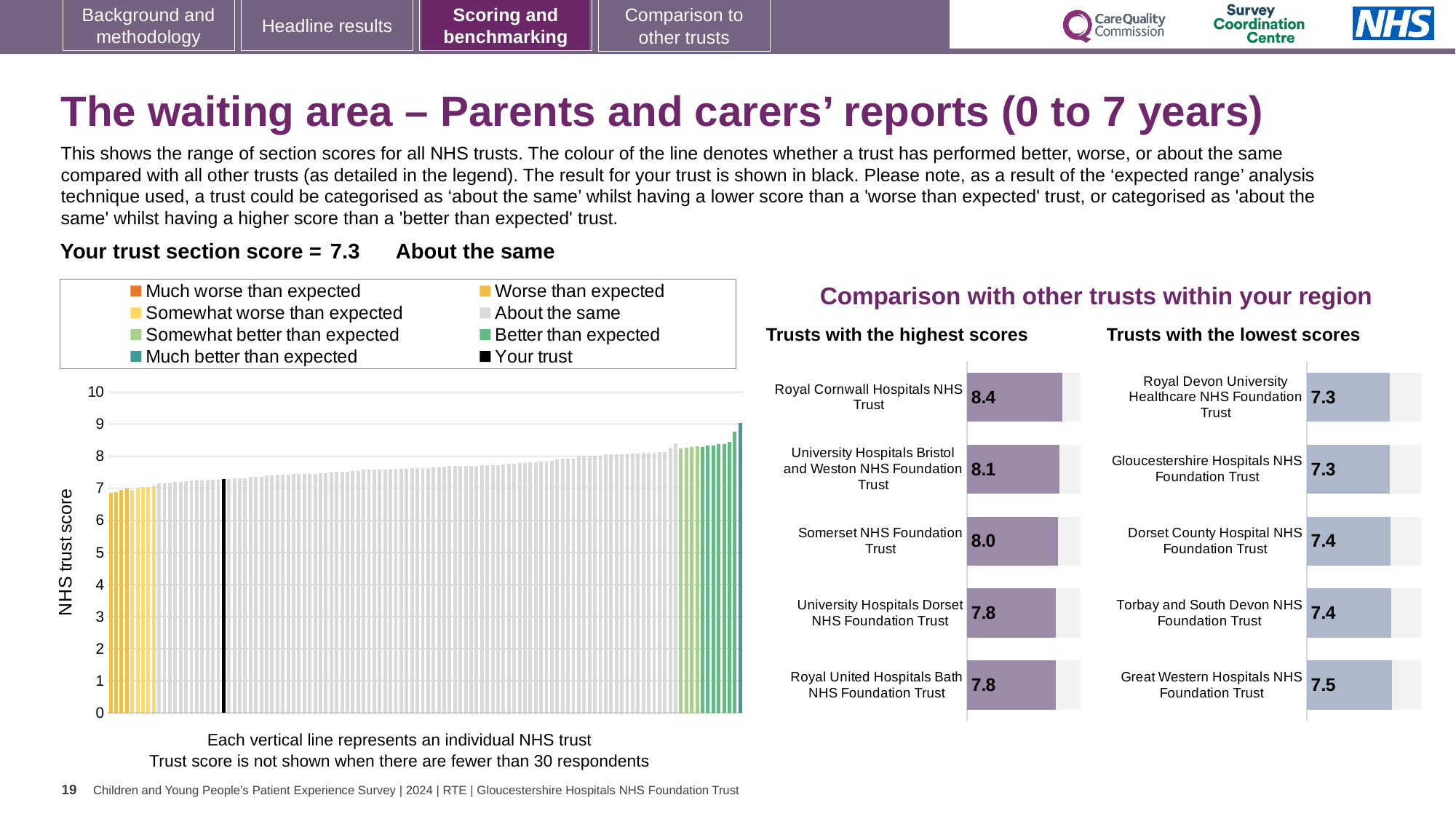
In the 'Trusts with the lowest scores' chart, what is the score for Great Western Hospitals NHS Foundation Trust? 7.5 In the 'Trusts with the highest scores' chart, what is the score for Somerset NHS Foundation Trust? 8.0 In the 'Trusts with the highest scores' chart, what is the score for Royal Cornwall Hospitals NHS Trust? 8.4 In the 'Trusts with the lowest scores' chart, which trust has the highest score shown? Great Western Hospitals NHS Foundation Trust In the NHS trust score chart on the left, do the bar values rise or fall from left to right? rise How many entries does the legend of the NHS trust score chart on the left list? 8 In the 'Trusts with the highest scores' chart, what is the difference between the scores of Royal Cornwall Hospitals NHS Trust and Royal United Hospitals Bath NHS Foundation Trust? 0.6 In the NHS trust score chart on the left, is the value for the black 'Your trust' bar greater or less than 7? greater In the 'Trusts with the lowest scores' chart, what is the difference between the scores of Great Western Hospitals NHS Foundation Trust and Gloucestershire Hospitals NHS Foundation Trust? 0.2 In the 'Trusts with the highest scores' chart, which has the larger score: Somerset NHS Foundation Trust or University Hospitals Dorset NHS Foundation Trust? Somerset NHS Foundation Trust How many trusts are listed in the 'Trusts with the lowest scores' chart? 5 In the 'Trusts with the highest scores' chart, which trust has the highest score? Royal Cornwall Hospitals NHS Trust